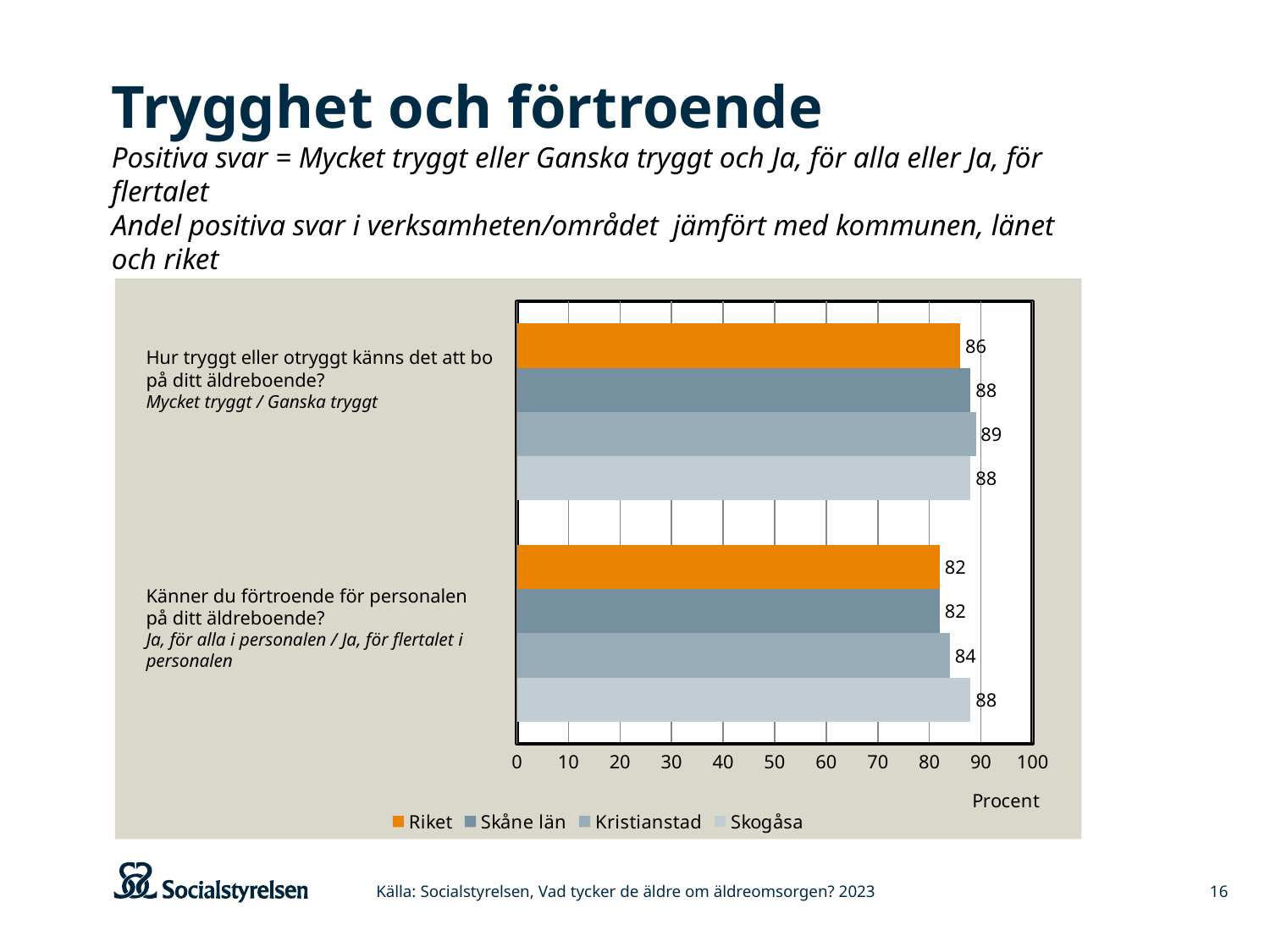
What is the difference between Skogåsa and Riket on the question "Känner du förtroende för personalen på ditt äldreboende?"? 6 How many questions (categories) are shown on the chart? 2 Which series has the lowest value on the question "Hur tryggt eller otryggt känns det att bo på ditt äldreboende?"? Riket Which series has the highest value on the question "Känner du förtroende för personalen på ditt äldreboende?"? Skogåsa What is the value for Kristianstad on the question "Hur tryggt eller otryggt känns det att bo på ditt äldreboende?"? 89 What is the label of the x axis? Procent What is the value for Skåne län on the question "Känner du förtroende för personalen på ditt äldreboende?"? 82 What is the value for Skogåsa on the question "Känner du förtroende för personalen på ditt äldreboende?"? 88 How many series does the legend list? 4 Which is larger on the question "Känner du förtroende för personalen på ditt äldreboende?": Kristianstad or Riket? Kristianstad What is the value for Riket on the question "Hur tryggt eller otryggt känns det att bo på ditt äldreboende?"? 86 What kind of chart is shown on the slide? Bar chart